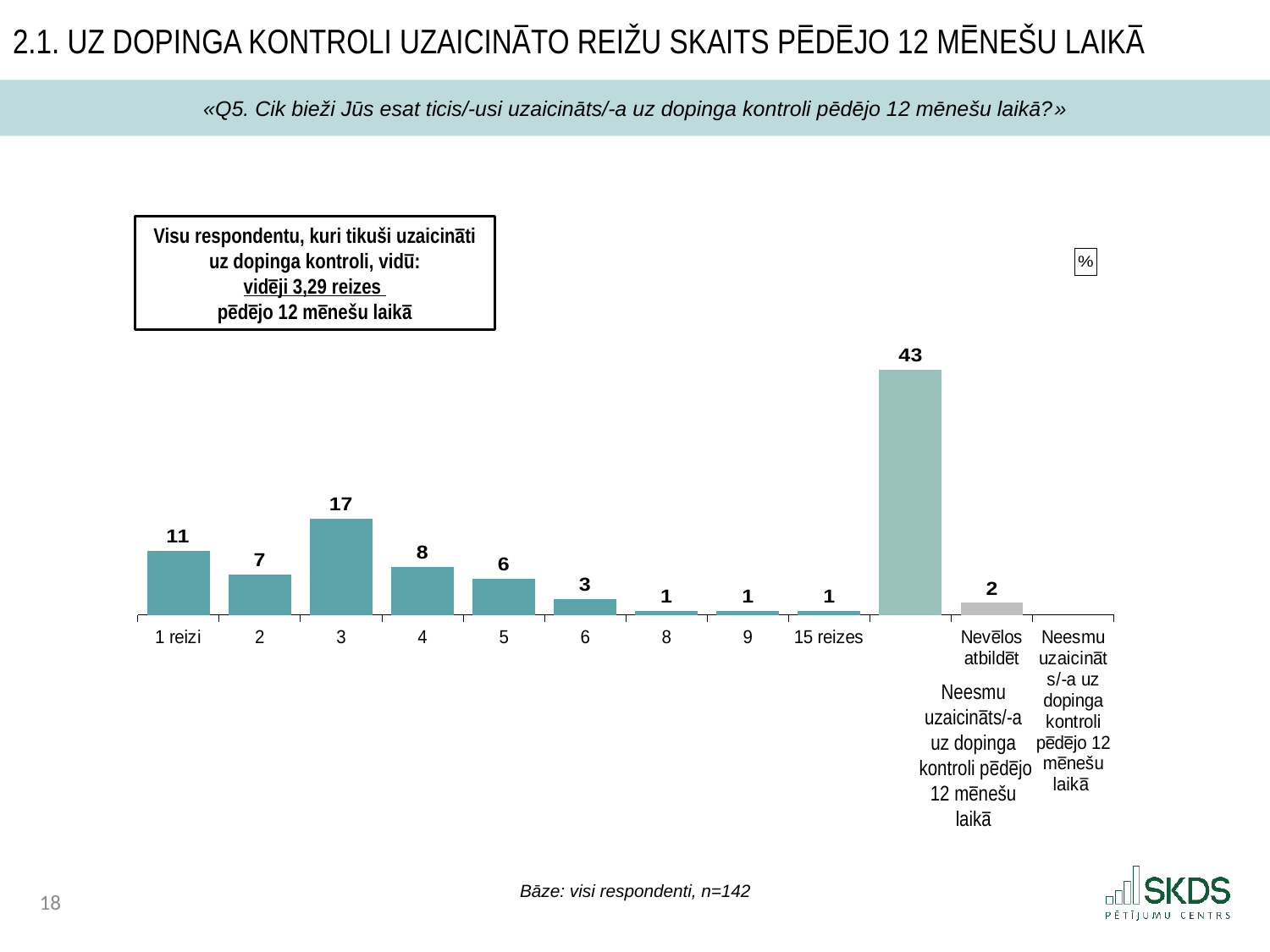
Among the numbered categories (1 reizi to 15 reizes), which has the highest value? 3 What is the value for the category "15 reizes"? 1 What is the difference between the values for "3" and "1 reizi"? 6 Which is larger, the value for "4" or the value for "5"? 4 What is the value for the category "1 reizi"? 11 Do the values rise or fall from category "3" to category "6"? fall What is the value for the category "Neesmu uzaicināts/-a uz dopinga kontroli pēdējo 12 mēnešu laikā"? 43 What is the value for the category "Nevēlos atbildēt"? 2 What kind of chart is shown on the slide? bar chart According to the text box, what is the average number of times respondents were invited to doping control in the last 12 months? 3,29 reizes Which category has the highest value? Neesmu uzaicināts/-a uz dopinga kontroli pēdējo 12 mēnešu laikā What is the value for the category "3"? 17